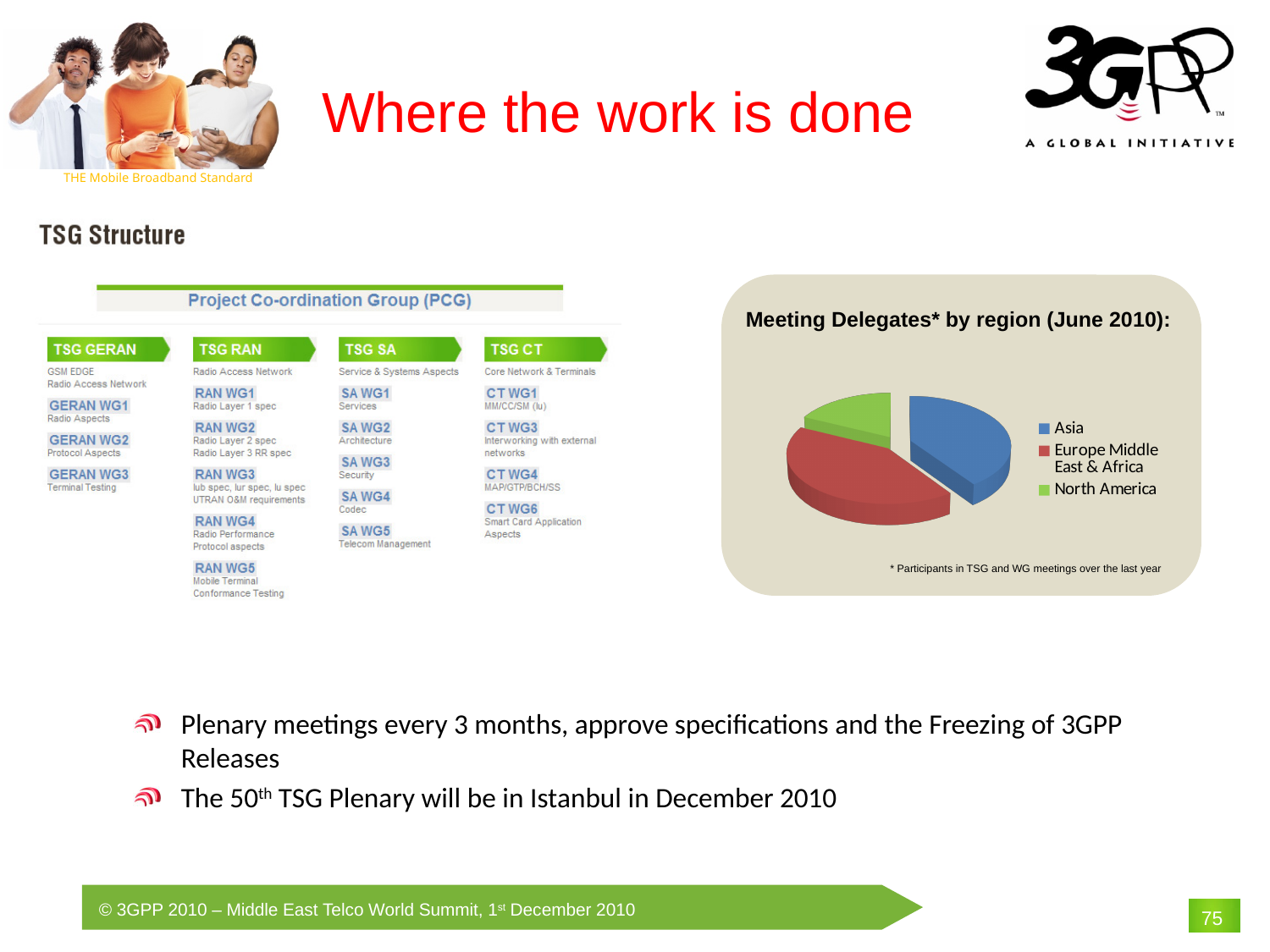
Which region has the smallest share of meeting delegates in the pie chart? North America Which region has the largest share of meeting delegates in the pie chart? Europe Middle East & Africa In the pie chart, which has the larger share: Asia or North America? Asia How many regions (slices) does the pie chart show? 3 How many entries does the legend of the pie chart list? 3 What kind of chart is shown on the slide? pie chart In the pie chart, which has the larger share: Europe Middle East & Africa or Asia? Europe Middle East & Africa Which colour represents Asia in the pie chart? blue What is the title of the pie chart? Meeting Delegates* by region (June 2010):